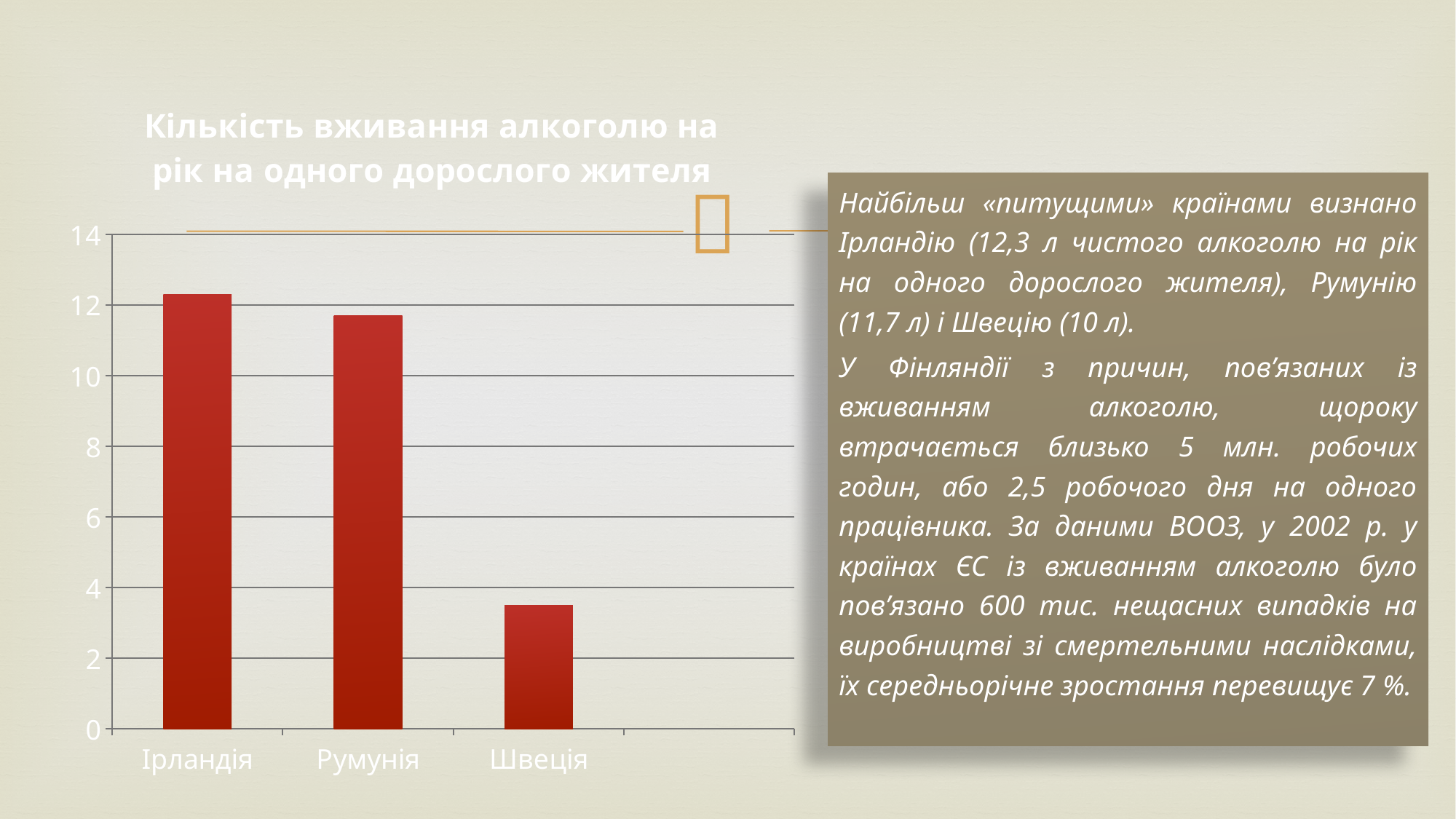
What is the highest value shown on the vertical axis of the chart? 14 Is the value for Ірландія greater or less than 12? greater How many countries are plotted in the chart? 3 Which country has the lowest bar in the chart? Швеція What is the title of the chart? Кількість вживання алкоголю на рік на одного дорослого жителя Is the value for Румунія greater or less than 10? greater Is the value for Швеція greater or less than 4? less Which is larger, the value for Румунія or the value for Швеція? Румунія What kind of chart is shown on the slide? bar chart Do the bar values rise or fall from left to right across the x axis? fall Which country has the highest bar in the chart? Ірландія